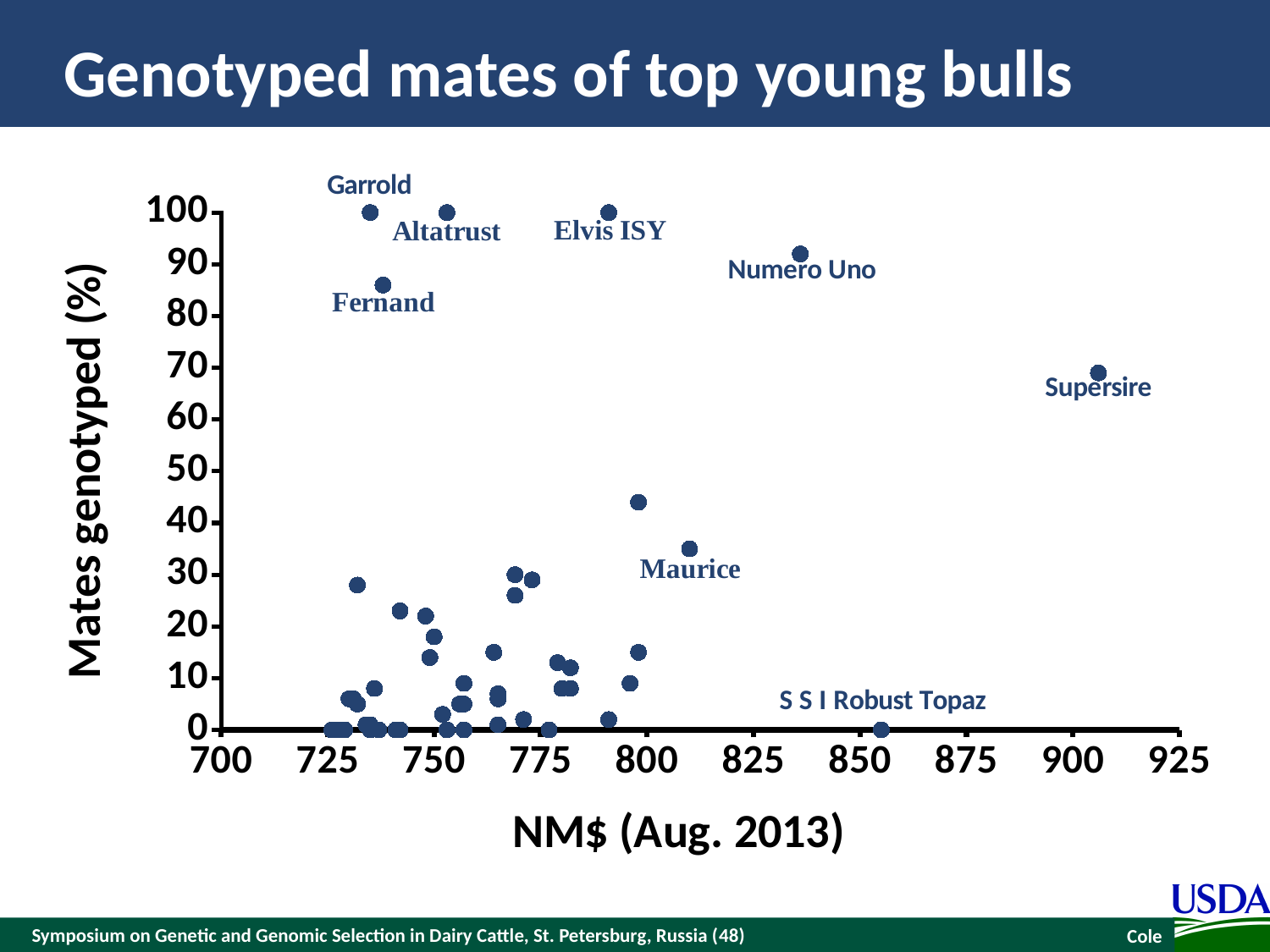
Is the NM$ value for Supersire greater or less than 900? greater Which has a higher percentage of mates genotyped, Numero Uno or Supersire? Numero Uno What percentage of mates genotyped is shown for Garrold? 100 What is the label of the x axis? NM$ (Aug. 2013) Is the percentage of mates genotyped for Supersire greater or less than 60? greater Which labeled bull has the highest NM$ value? Supersire Is the percentage of mates genotyped for Maurice greater or less than 40? less What percentage of mates genotyped is shown for S S I Robust Topaz? 0 What type of chart is shown on the slide? Scatter plot Which labeled bull has the lowest percentage of mates genotyped? S S I Robust Topaz What is the title of the chart on the slide? Genotyped mates of top young bulls